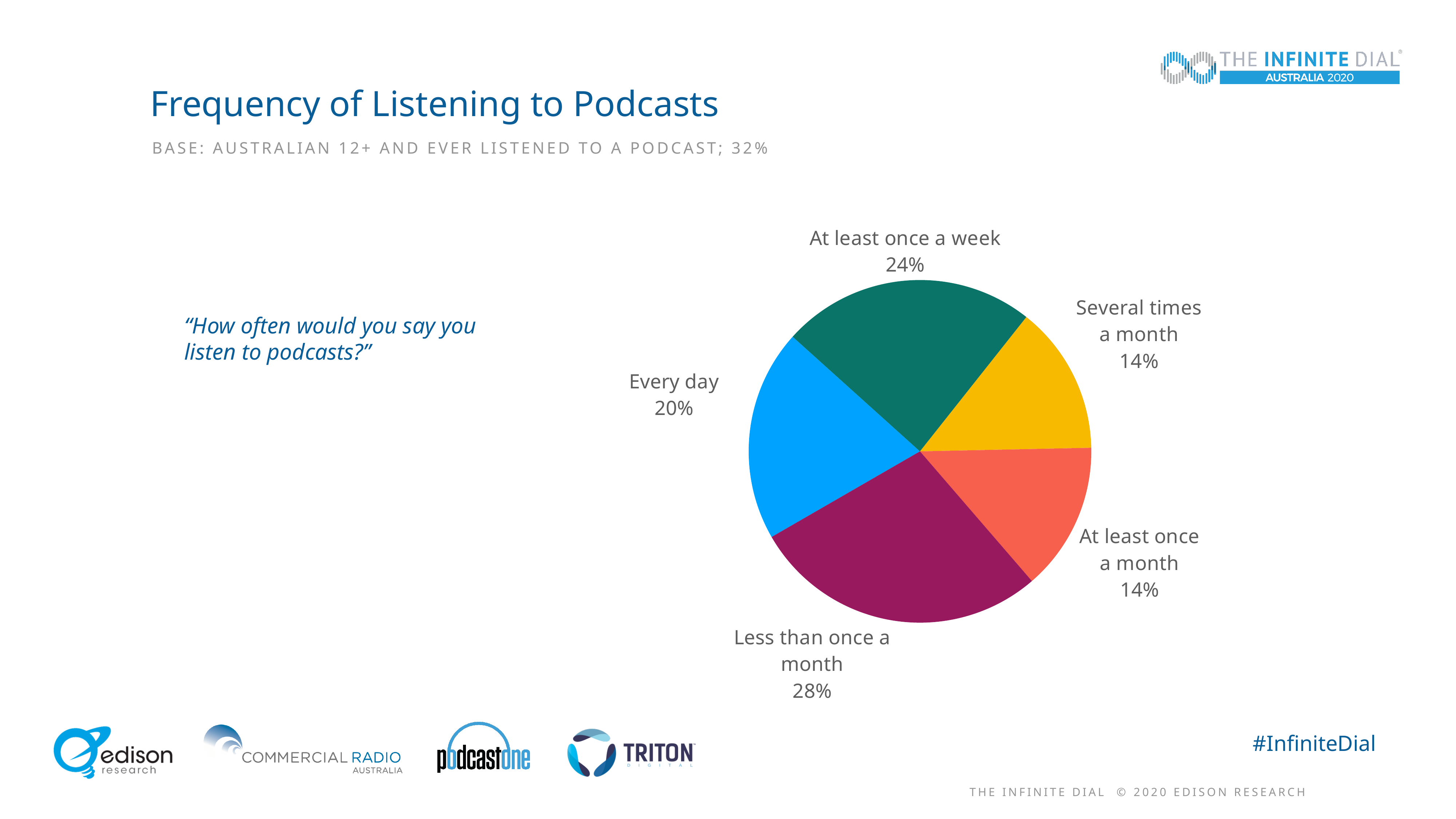
What percentage of podcast listeners listen less than once a month? 28% What is the difference in percentage points between 'Less than once a month' and 'Every day'? 8 How many slices does the pie chart have? 5 Which is larger, the share for 'At least once a week' or the share for 'Every day'? At least once a week What percentage of podcast listeners listen several times a month? 14% Which listening frequency has the largest share of the pie? Less than once a month What colour is the 'Every day' slice of the pie? Blue What is the combined share of 'Several times a month' and 'At least once a month'? 28% What percentage of podcast listeners listen every day? 20% What percentage of podcast listeners listen at least once a week? 24% What is the title of the chart on the slide? Frequency of Listening to Podcasts What kind of chart is shown on the slide? Pie chart